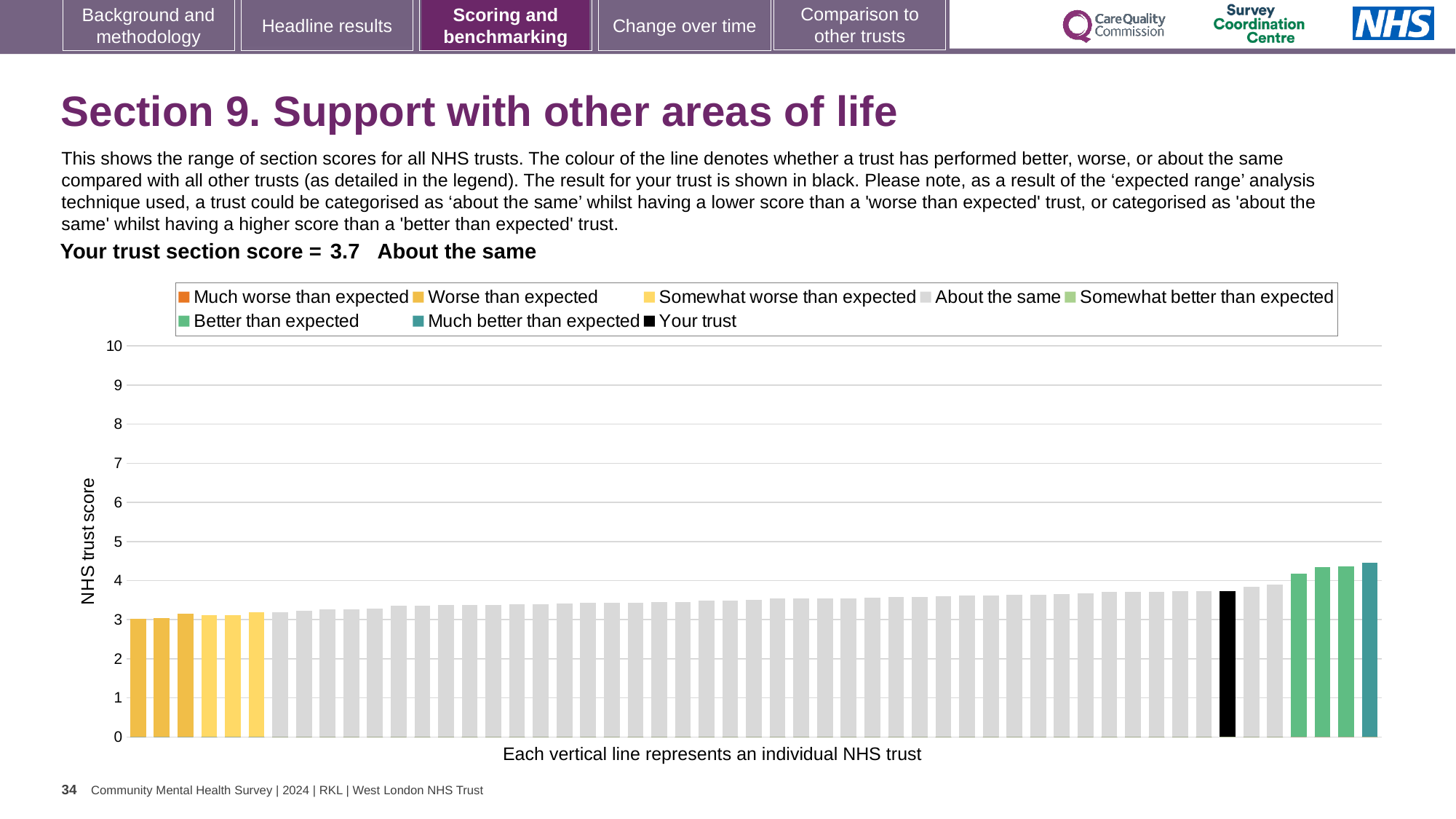
Is the value of the black bar (your trust) greater or less than 4? less Is the value of the tallest bar greater or less than 4? greater What is the label on the vertical axis of the chart? NHS trust score What is the section score for your trust shown on the slide? 3.7 Do the bar values rise or fall from left to right along the x axis? Rise How many bars are positioned to the right of the black bar? 6 Is the value of the black bar (your trust) greater or less than 3? greater What kind of chart is shown on the slide? Bar chart What colour is used for the bar representing your trust? Black How many entries does the chart legend list? 8 Which performance category is your trust placed in for this section? About the same